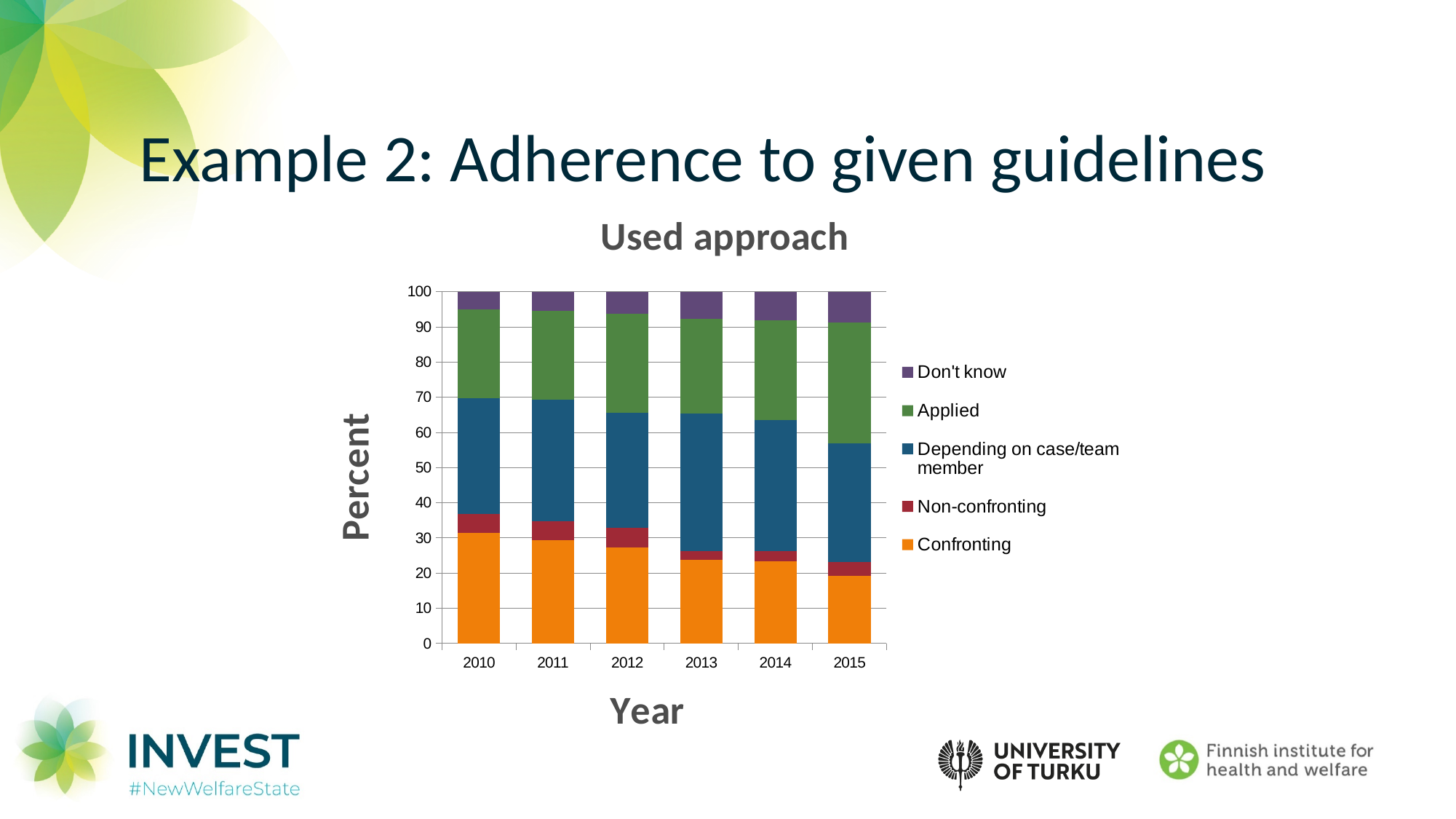
Does the Confronting share rise or fall from 2010 to 2015? fall How many series does the legend list? 5 What is the title of the chart? Used approach Is the value for Confronting in 2010 greater or less than 30? greater In which year is the Confronting share highest? 2010 Is the value for Confronting in 2013 greater or less than 30? less What is the label of the y axis? Percent In which year is the Confronting share lowest? 2015 What is the total of the stacked bar for 2012? 100 What type of chart is shown on the slide? Stacked bar chart Is the value for Confronting in 2015 greater or less than 25? less How many years are shown on the x axis? 6